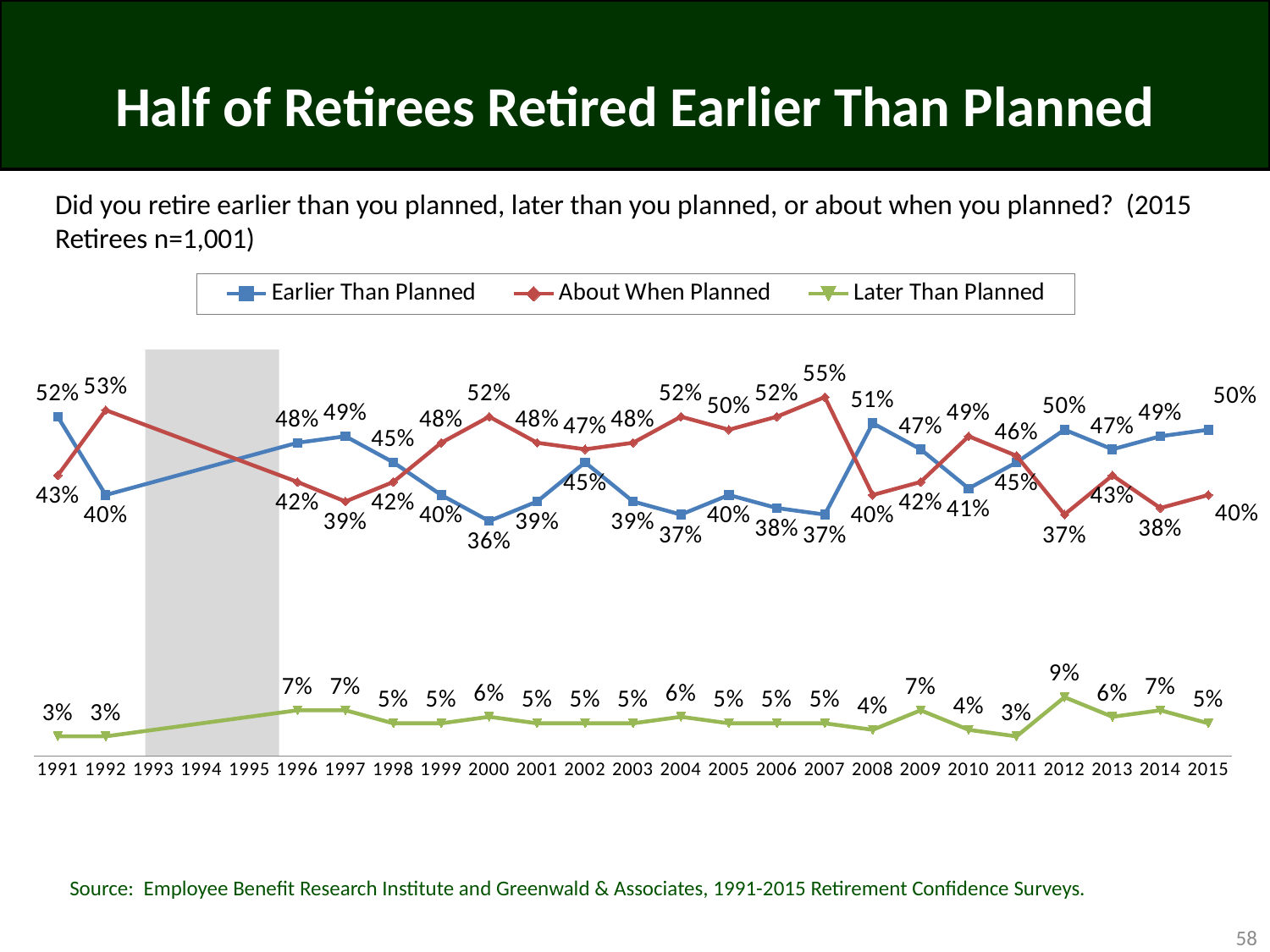
Which series is shown in green in the legend? Later Than Planned Which series has the higher value in 2007, Earlier Than Planned or About When Planned? About When Planned What is the value for Earlier Than Planned in 2015? 50% What is the value for About When Planned in 1992? 53% In which year is the Later Than Planned series at its highest? 2012 What is the value for Earlier Than Planned in 2008? 51% What is the difference between Earlier Than Planned and About When Planned in 2015? 10 percentage points How many series does the legend list? 3 What is the value for About When Planned in 2007? 55% What type of chart is shown on the slide? Line chart In which year is the Earlier Than Planned series at its lowest? 2000 What is the value for Later Than Planned in 2012? 9%